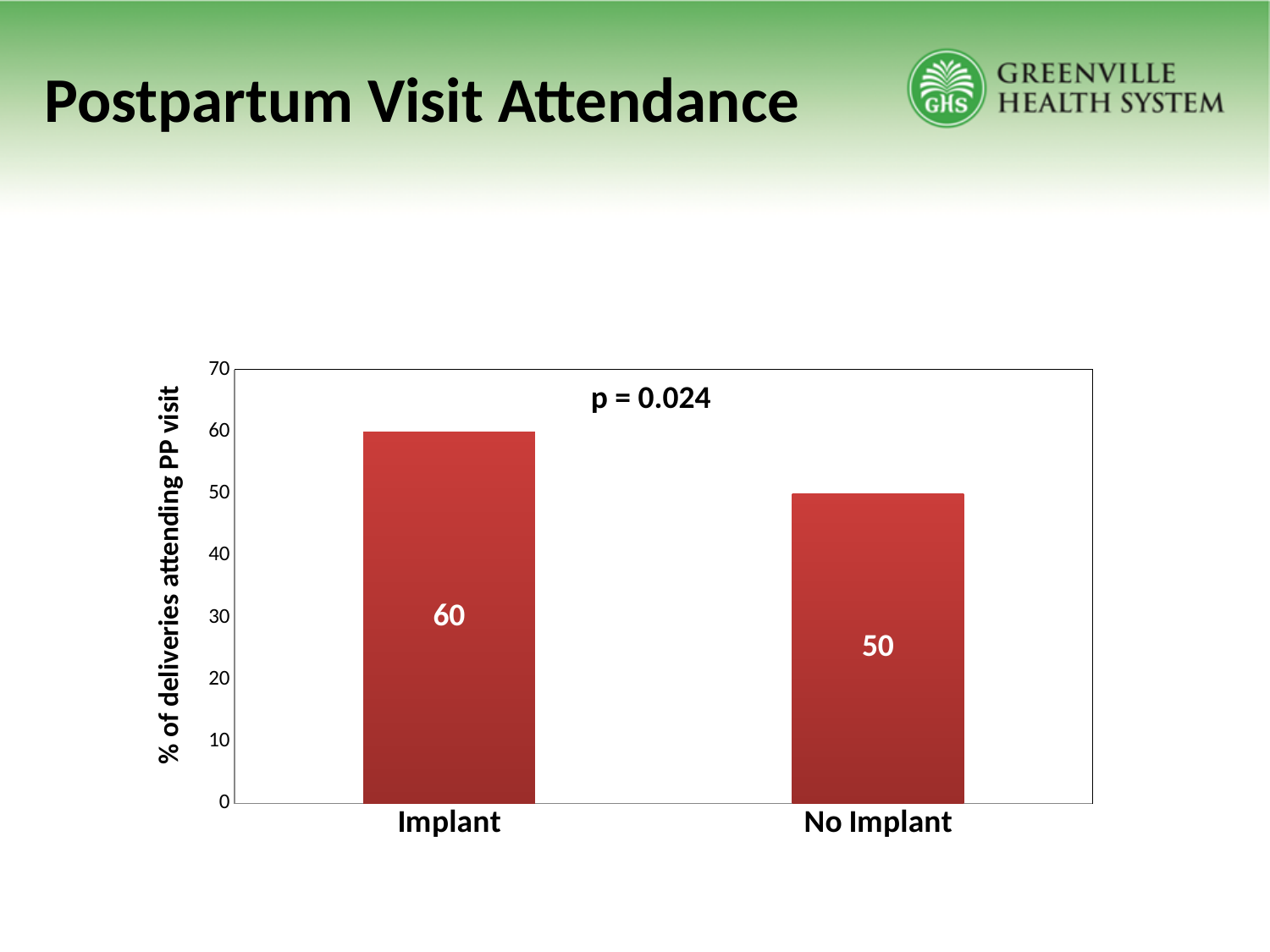
What is the value for No Implant? 50 What is the difference between the values for Implant and No Implant? 10 Which category has the highest value? Implant Which category has the lowest value? No Implant Is the value for No Implant greater or less than 40? greater What is the maximum value shown on the y axis? 70 What is the label of the y axis? % of deliveries attending PP visit What kind of chart is shown on the slide? bar chart How many categories are shown on the x axis? 2 What is the value for Implant? 60 Which is larger, the value for Implant or the value for No Implant? Implant What p-value is printed on the chart? p = 0.024